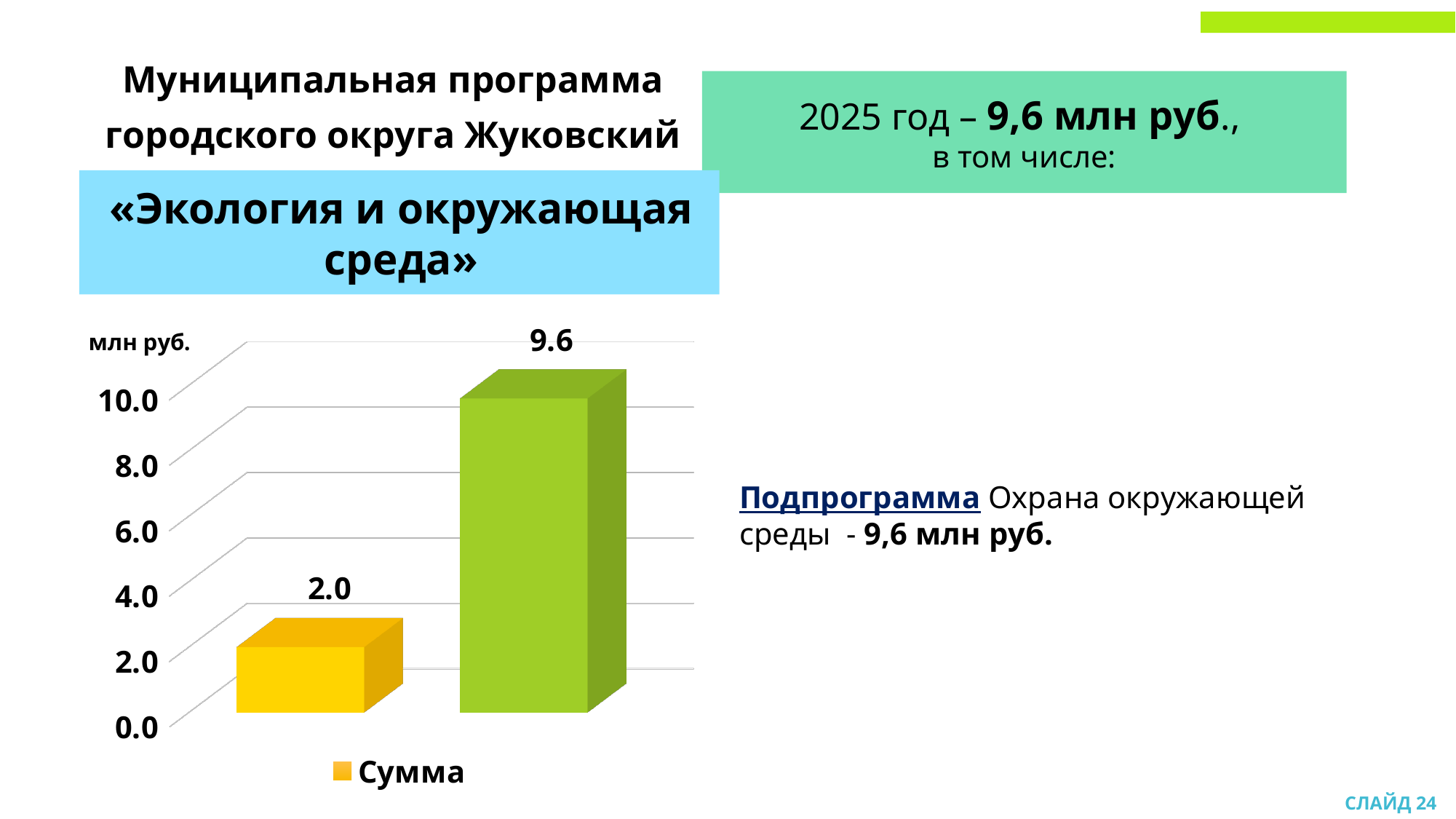
How many bars are plotted in the chart? 2 What value is shown on the data label of the green bar? 9.6 What unit is written above the vertical axis of the chart? млн руб. How many series does the legend list? 1 Which bar is taller, the yellow one or the green one? the green one What is the highest value shown on the chart's data labels? 9.6 What kind of chart is shown on the slide? bar chart What is the name of the series listed in the chart legend? Сумма Is the value of the green bar greater or less than 8.0? greater What is the difference between the values of the green bar and the yellow bar? 7.6 What value is shown on the data label of the yellow bar? 2.0 Is the value of the yellow bar greater or less than 4.0? less